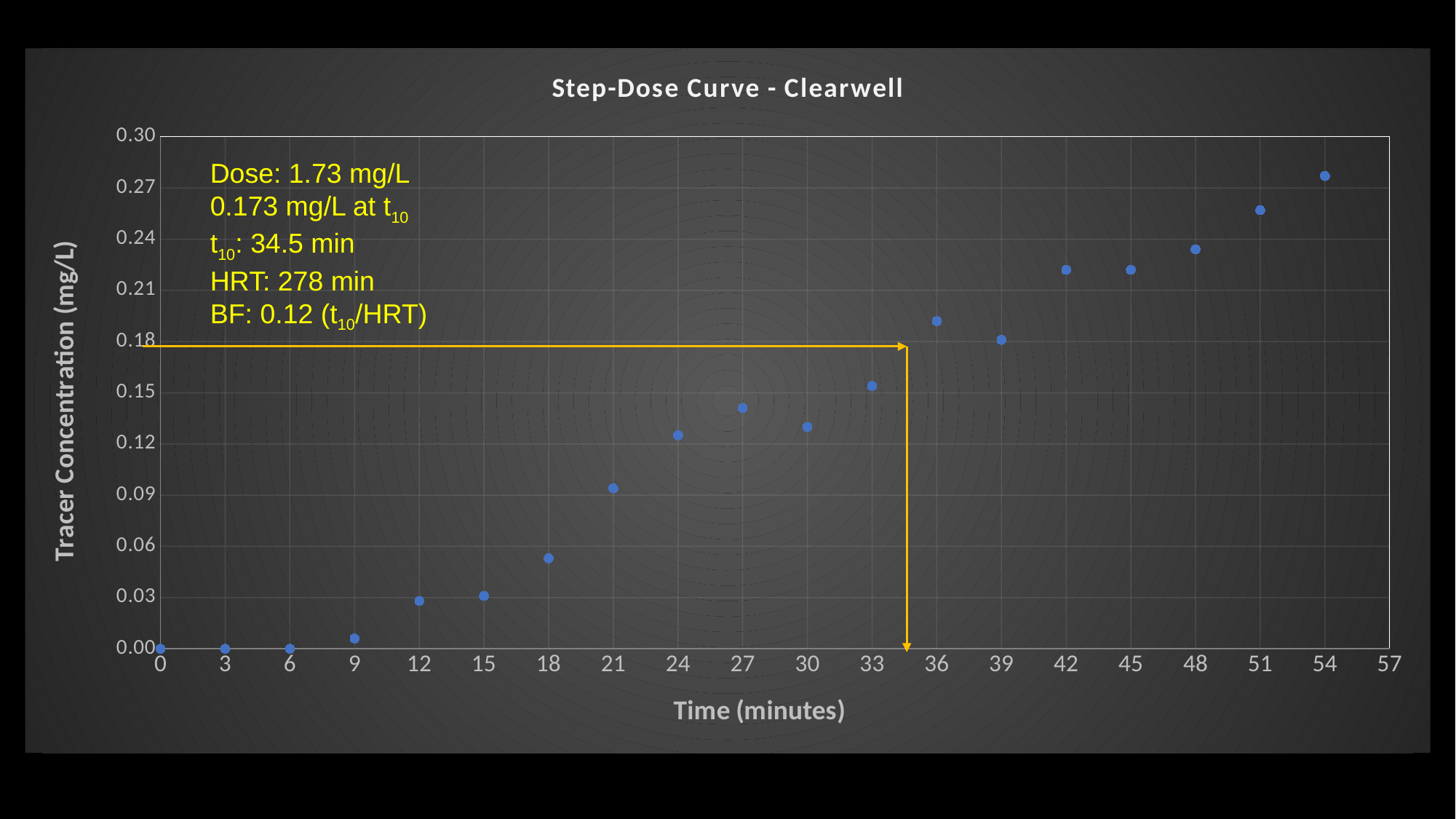
Is the tracer concentration at 27 minutes greater or less than 0.15? less What is the tracer concentration at 0 minutes? 0.00 Do the tracer concentration values generally rise or fall as time increases? rise Is the tracer concentration at 42 minutes greater or less than 0.21? greater According to the annotation on the chart, what is the HRT value? 278 min Is the tracer concentration at 18 minutes greater or less than 0.06? less Which has the higher tracer concentration, 36 minutes or 39 minutes? 36 minutes At which time (in minutes) is the tracer concentration highest? 54 What is the title of the chart? Step-Dose Curve - Clearwell How many data points are plotted on the chart? 19 What kind of chart is shown on the slide? scatter chart